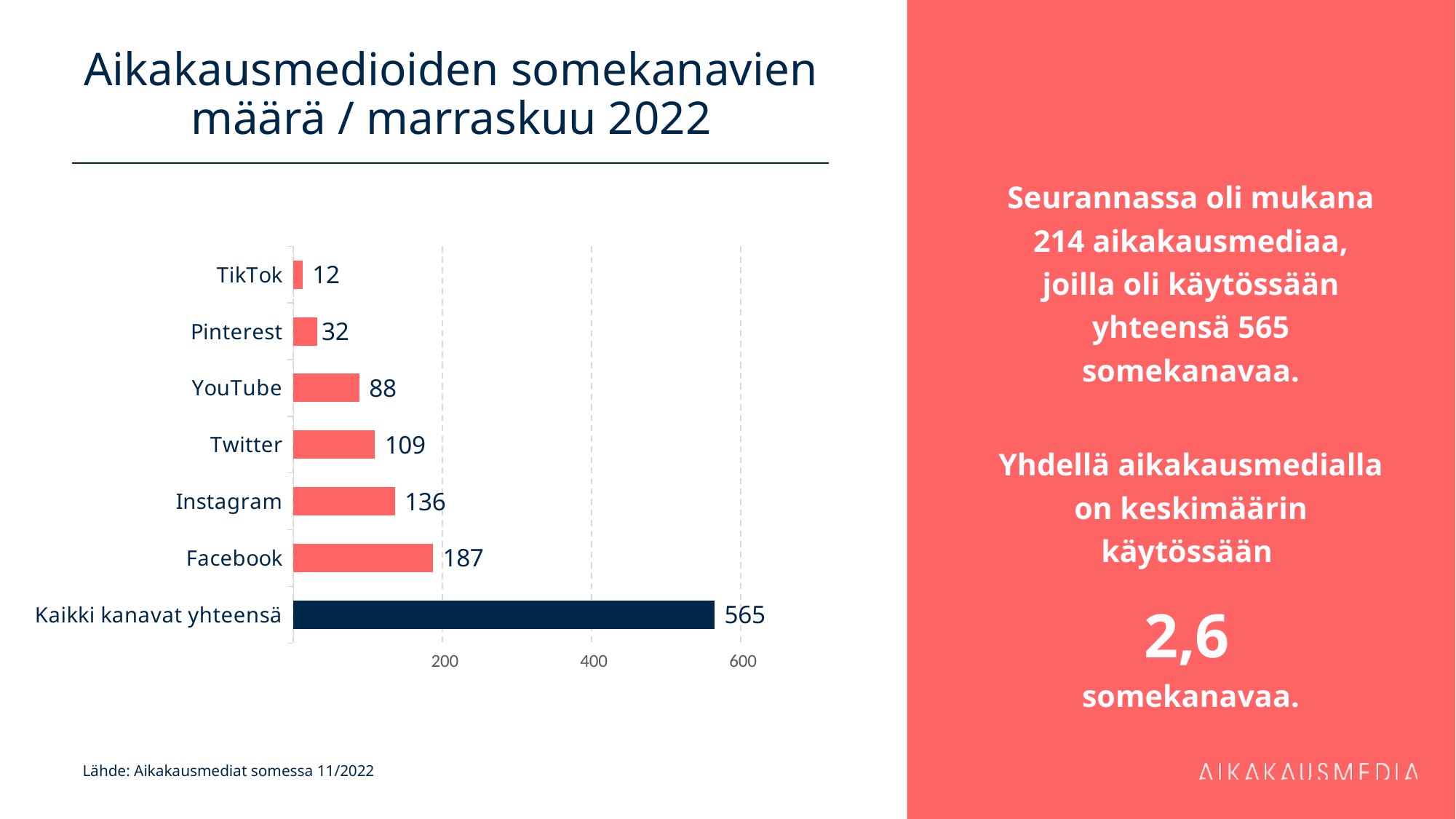
What is the difference between the values for Twitter and YouTube? 21 Which is larger, the value for Pinterest or the value for YouTube? YouTube Which individual channel (excluding the total bar) has the highest value? Facebook What is the difference between the values for Facebook and Instagram? 51 What kind of chart is shown on the slide? bar chart Which category has the lowest value? TikTok What is the value for Kaikki kanavat yhteensä? 565 What is the value for Facebook? 187 What is the value for Instagram? 136 Is the value for Facebook greater or less than 200? less What is the value for TikTok? 12 How many categories are shown in the chart? 7